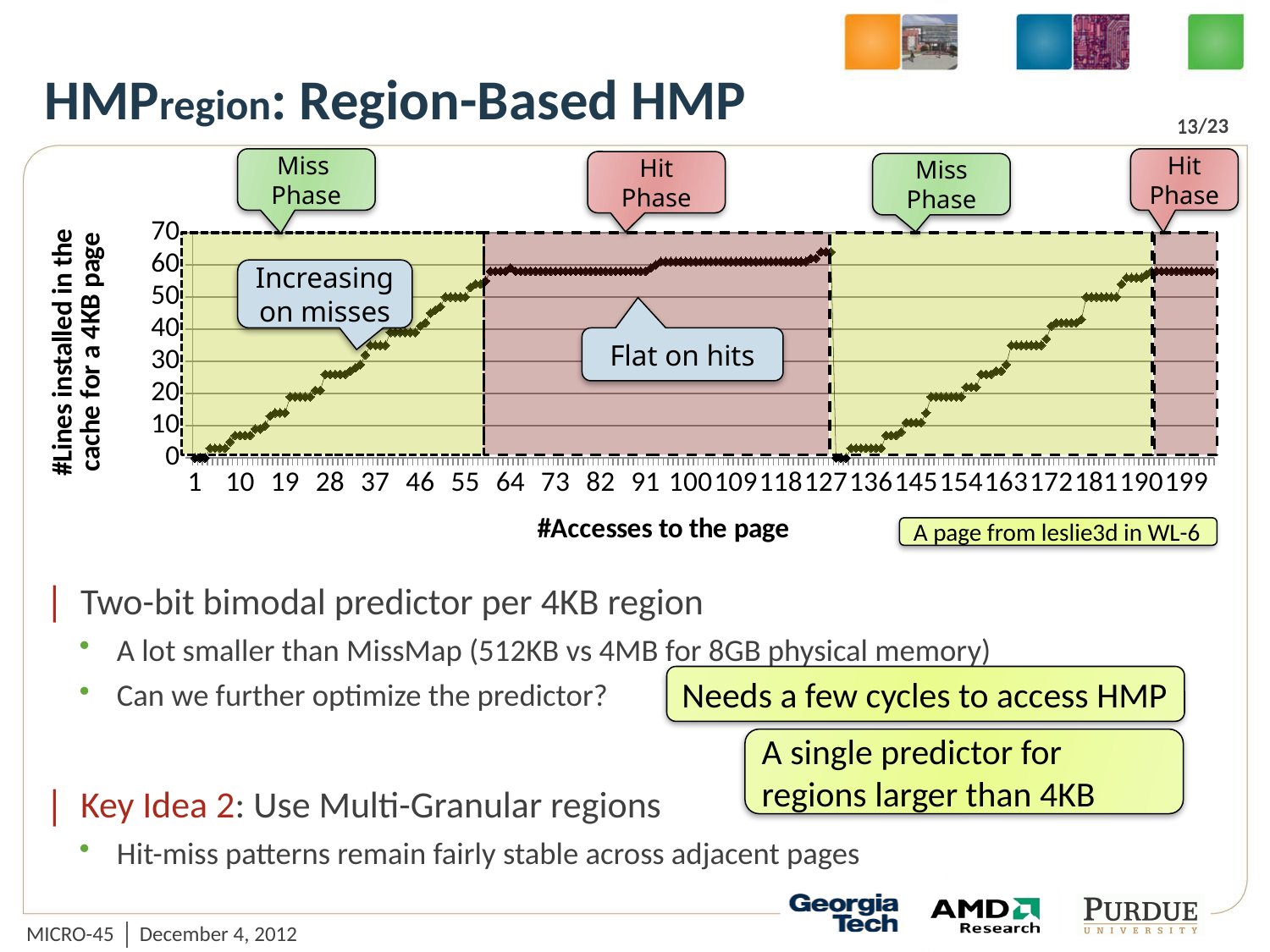
What is the title of the y axis of the chart? #Lines installed in the cache for a 4KB page Which is larger, the value at access 46 or the value at access 145? the value at access 46 Is the value at access 19 greater or less than 30? less What is the title of the x axis of the chart? #Accesses to the page Is the value at access 199 greater or less than 40? greater Is the value at access 136 greater or less than 10? less Do the values rise or fall between access 1 and access 55? rise Do the values rise, fall, or stay flat between access 82 and access 91? stay flat What is the highest value shown on the y axis of the chart? 70 What kind of chart is shown on the slide? line chart